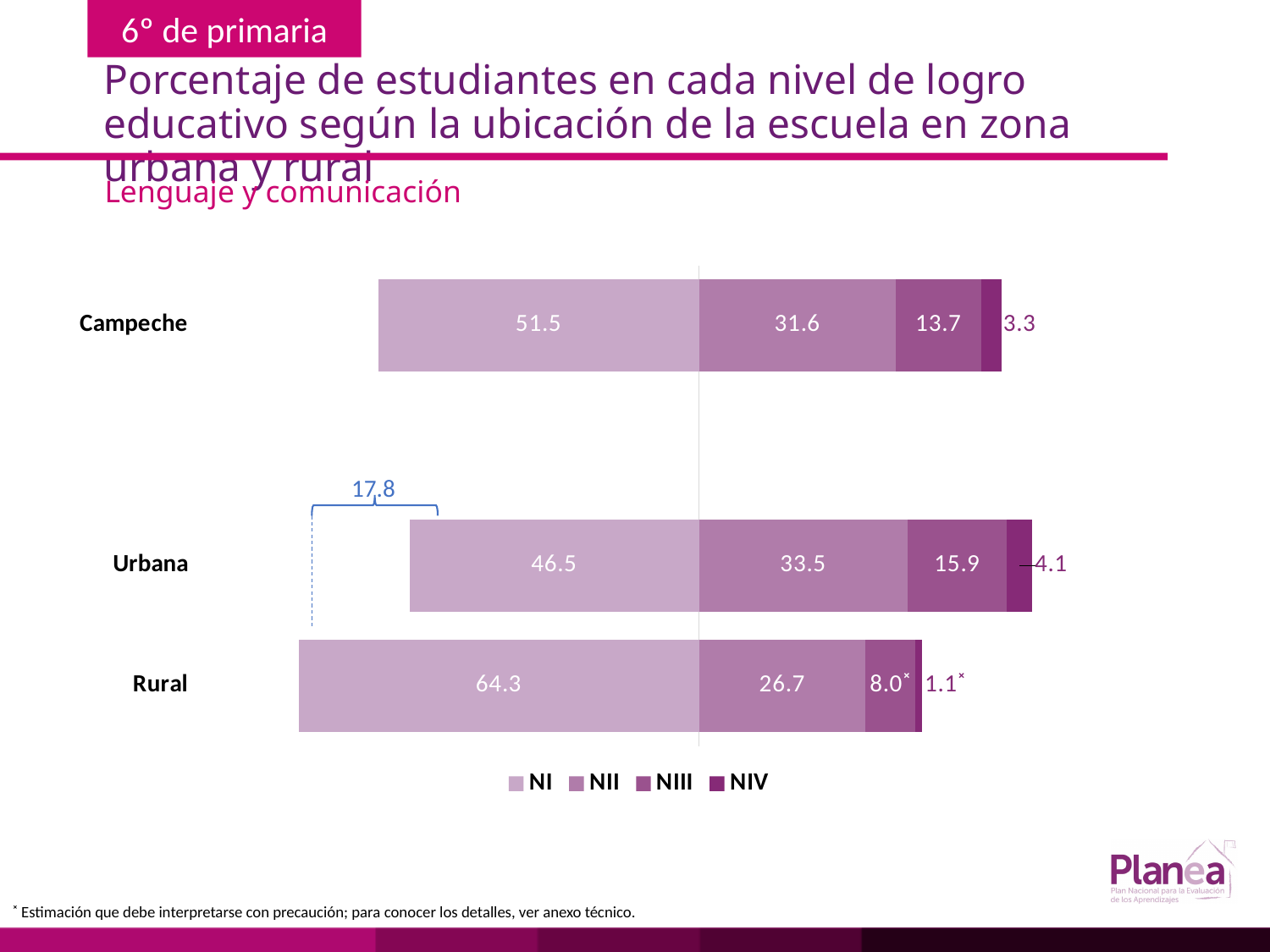
Which category has the lowest NIV value? Rural Which category has the highest NI value? Rural What are the legend entries of the chart, in order? NI, NII, NIII, NIV How many series does the legend list? 4 How many categories are plotted on the chart? 3 What is the difference between the NI values for Rural and Urbana? 17.8 What is the NIII value for Urbana? 15.9 What is the NIV value for Rural? 1.1 What is the NI value for Rural? 64.3 What type of chart is shown on the slide? Stacked bar chart What is the NII value for Campeche? 31.6 Which is larger, the NIII value for Campeche or the NIII value for Urbana? Urbana